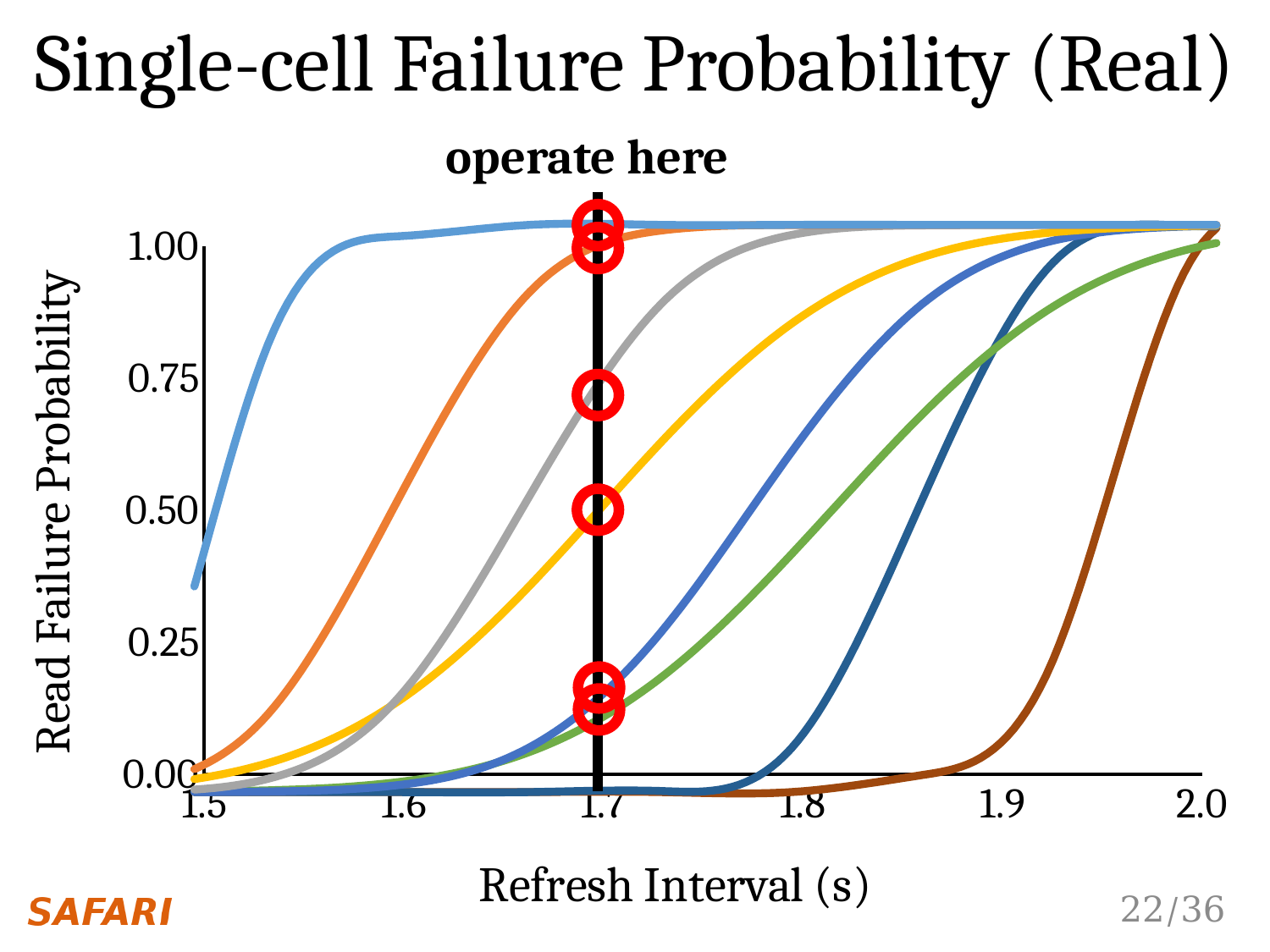
Is the value of the green curve at a refresh interval of 1.7 greater or less than 0.25? less Is the value of the orange curve at a refresh interval of 1.7 greater or less than 0.75? greater Is the value of the gray curve at a refresh interval of 1.7 greater or less than 0.50? greater What kind of chart is shown on the slide? line chart What is the label of the x axis of the chart? Refresh Interval (s) How many curves are plotted on the chart? 8 Do the curves rise or fall as the refresh interval increases along the x axis? rise At what refresh interval is the vertical 'operate here' line drawn? 1.7 Which curve is the last to rise toward a read failure probability of 1.00 as the refresh interval increases? brown curve At a refresh interval of 1.7, which curve has the larger read failure probability, the gray curve or the green curve? gray curve What is the title of the chart on the slide? Single-cell Failure Probability (Real)